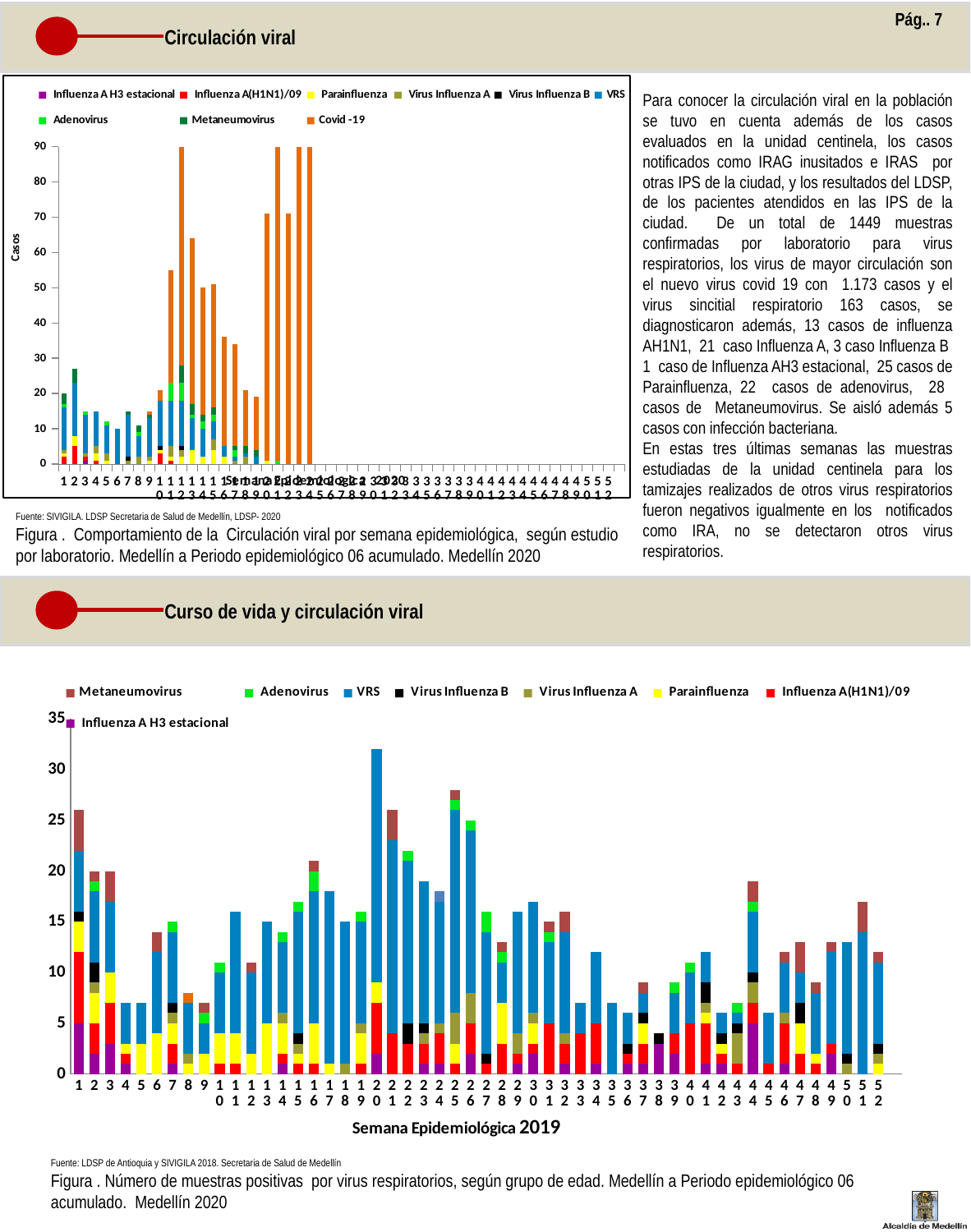
In the bottom chart, is the total for week 4 greater or less than 10? less How many series does the legend of the bottom chart list? 8 In the top chart, is the total for week 1 greater or less than 10? greater How many epidemiological weeks are labelled on the x-axis of the bottom chart? 52 What kind of chart is the top chart (Circulación viral)? Stacked bar chart In the top chart, which series is shown in orange? Covid -19 What kind of chart is the bottom chart (Curso de vida y circulación viral)? Stacked bar chart In the bottom chart, which bar is taller: week 1 or week 4? Week 1 In the bottom chart, which epidemiological week has the tallest stacked bar? 20 How many series does the legend of the top chart list? 9 What is the y-axis title of the top chart? Casos In the bottom chart, is the total for week 20 greater or less than 30? greater